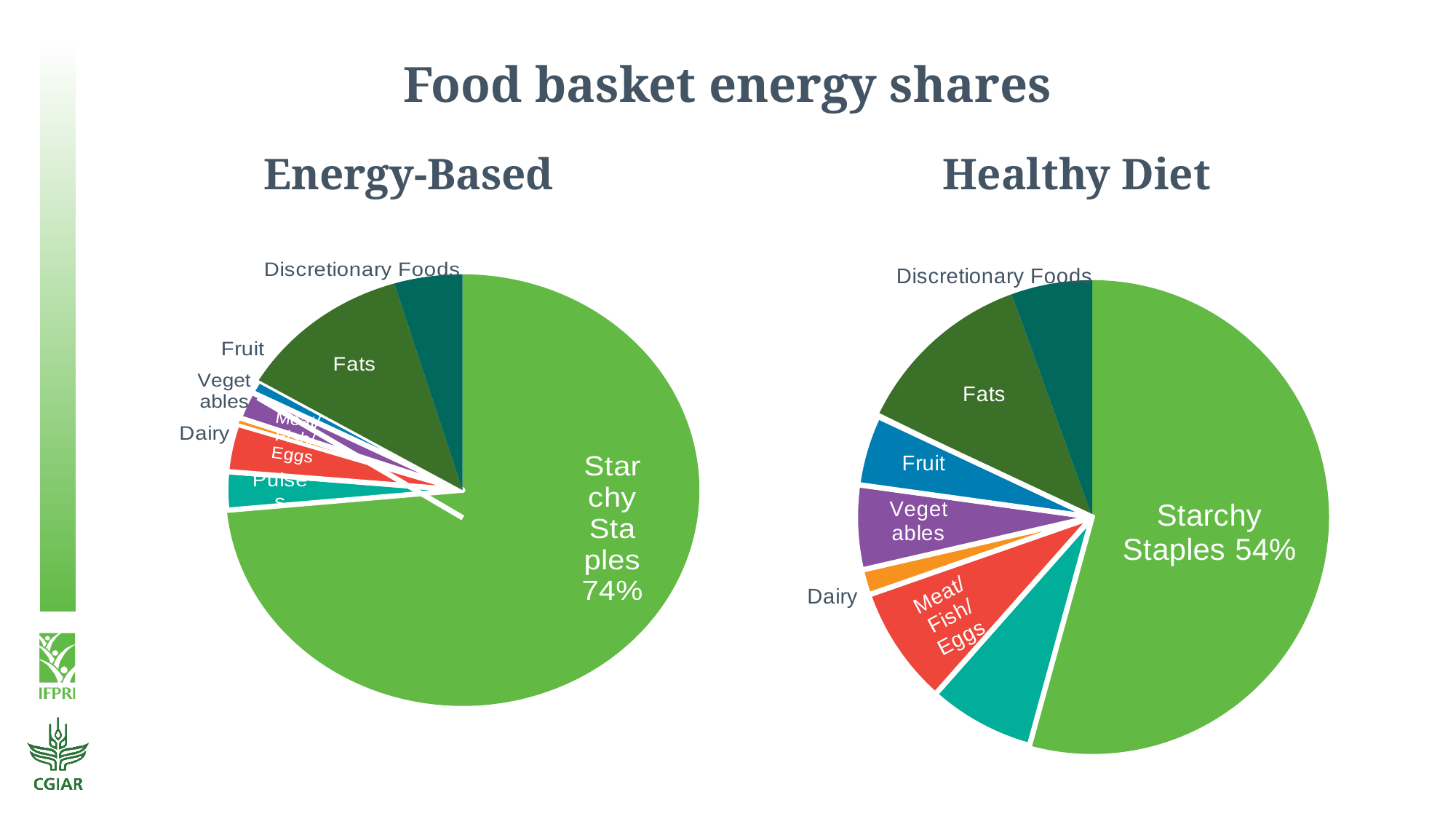
In the Energy-Based pie chart, which category has the largest slice? Starchy Staples How many slices does the Healthy Diet pie chart contain? 8 In the Energy-Based pie chart, which slice is larger, Fats or Discretionary Foods? Fats Comparing the two pie charts, how many percentage points larger is the Starchy Staples share in the Energy-Based chart than in the Healthy Diet chart? 20 percentage points Which pie chart shows the larger share for Starchy Staples, Energy-Based or Healthy Diet? Energy-Based In the Healthy Diet pie chart, what share is labelled for Starchy Staples? 54% What is the main title of the slide containing the two pie charts? Food basket energy shares In the Healthy Diet pie chart, which category has the largest slice? Starchy Staples In the Healthy Diet pie chart, which slice is larger, Fats or Fruit? Fats In the Healthy Diet pie chart, which labelled category has the smallest slice? Dairy What type of chart is used for the Energy-Based and Healthy Diet food baskets? Pie chart In the Energy-Based pie chart, what share is labelled for Starchy Staples? 74%